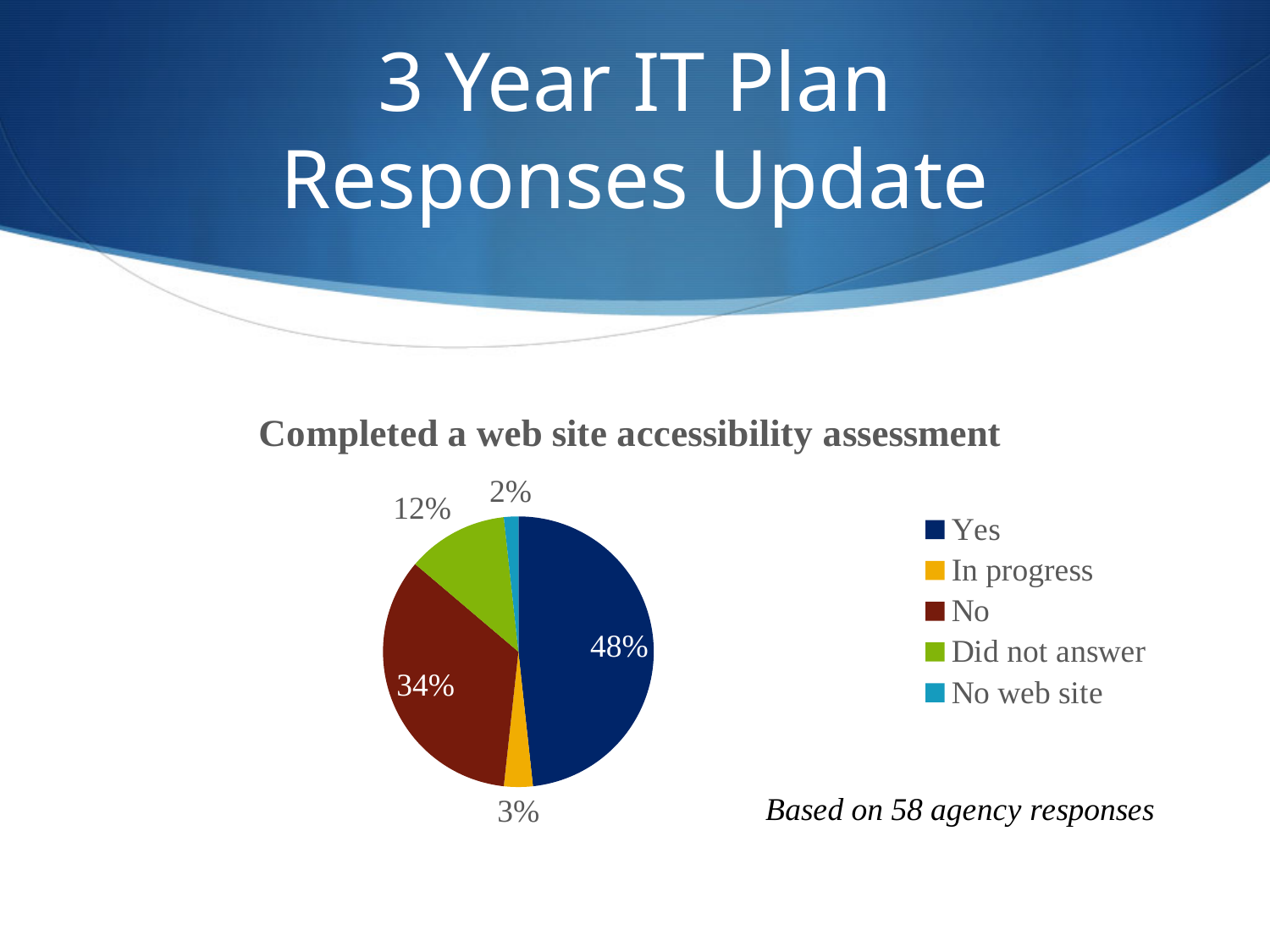
What percentage of responses are "Yes"? 48% Which category has the largest share of the pie? Yes What is the chart's title? Completed a web site accessibility assessment What percentage of responses are "No web site"? 2% What percentage of responses are "No"? 34% Which is larger, the share for "Did not answer" or the share for "In progress"? Did not answer Which category has the smallest share of the pie? No web site How many categories does the legend list? 5 What type of chart is shown on the slide? pie chart What is the difference in percentage points between "Yes" and "No"? 14 What percentage of responses are "In progress"? 3% What percentage of responses are "Did not answer"? 12%